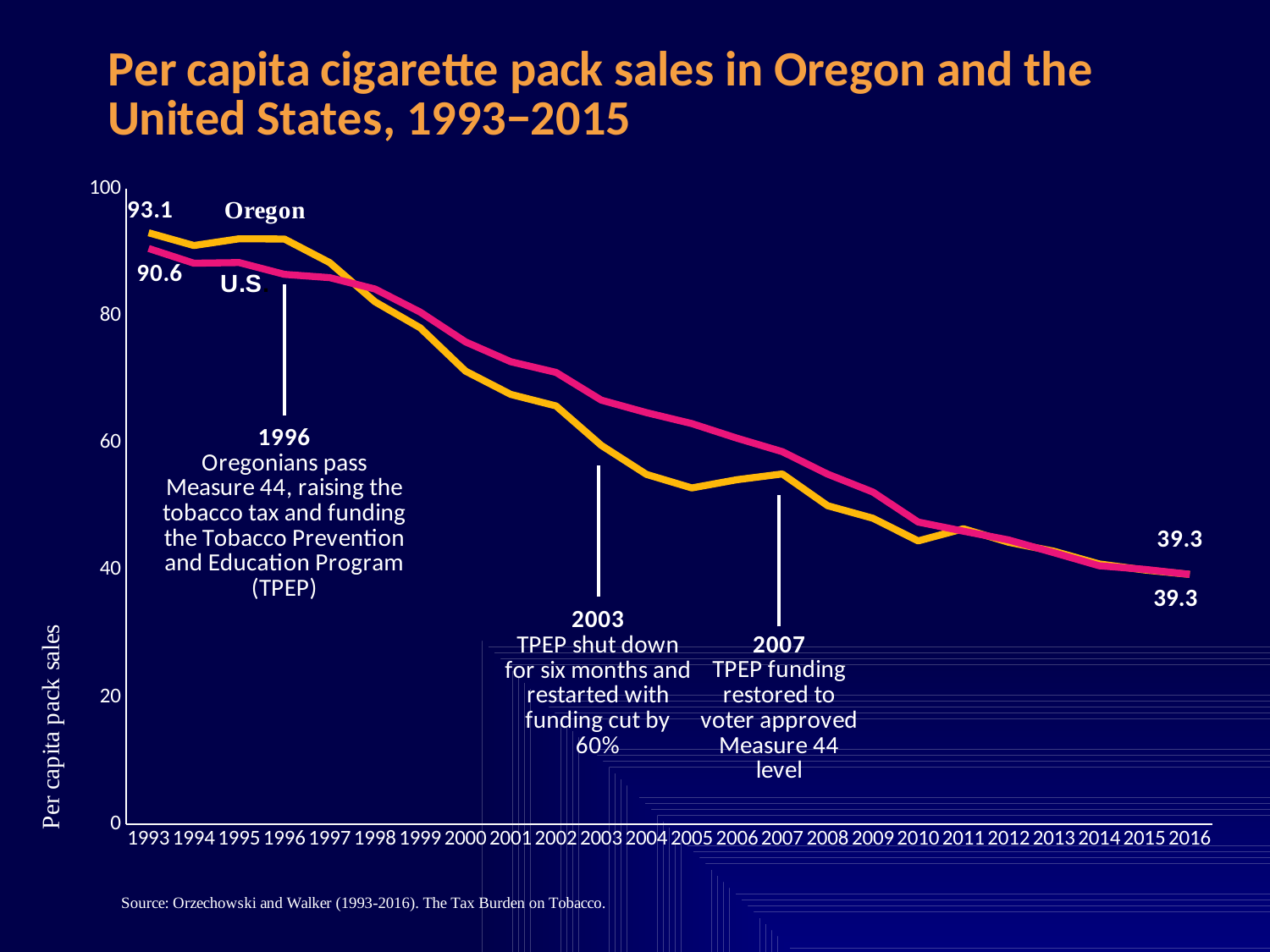
What is the per capita cigarette pack sales value for the U.S. in 1993? 90.6 Which series is drawn in yellow? Oregon How many series are plotted on the chart? 2 What kind of chart is shown on the slide? line chart What is the difference between the Oregon and U.S. values in 1993? 2.5 In 1993, which had higher per capita cigarette pack sales, Oregon or the U.S.? Oregon Is the value for the U.S. in 1998 greater or less than 80? greater Do per capita cigarette pack sales rise or fall from 1993 to 2015? fall What is the per capita cigarette pack sales value for Oregon in 1993? 93.1 Is the value for Oregon in 2010 greater or less than 50? less